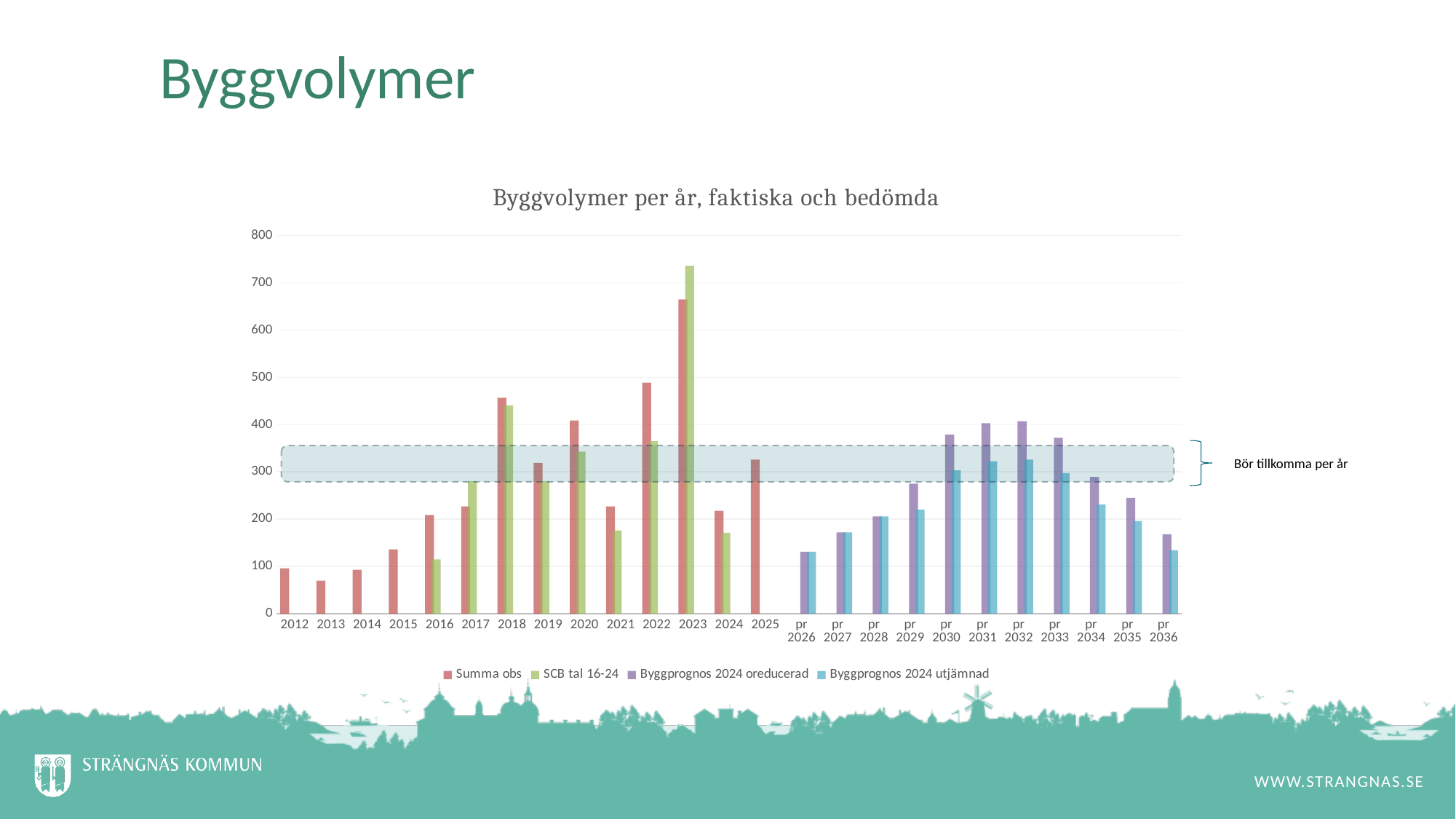
In which year is the Summa obs value lowest? 2013 Does the Byggprognos 2024 oreducerad series rise or fall from pr 2026 to pr 2032? rise How many series does the legend list? 4 In which year is the SCB tal 16-24 value highest? 2023 In which year is the Summa obs value highest? 2023 Is the SCB tal 16-24 value for 2023 greater or less than 700? greater What kind of chart is shown on the slide? bar chart What is the title of the chart? Byggvolymer per år, faktiska och bedömda Is the Summa obs value for 2023 greater or less than 600? greater How many year categories are shown on the x axis? 25 Is the Byggprognos 2024 utjämnad value for pr 2036 greater or less than 200? less For 2023, which is larger: Summa obs or SCB tal 16-24? SCB tal 16-24